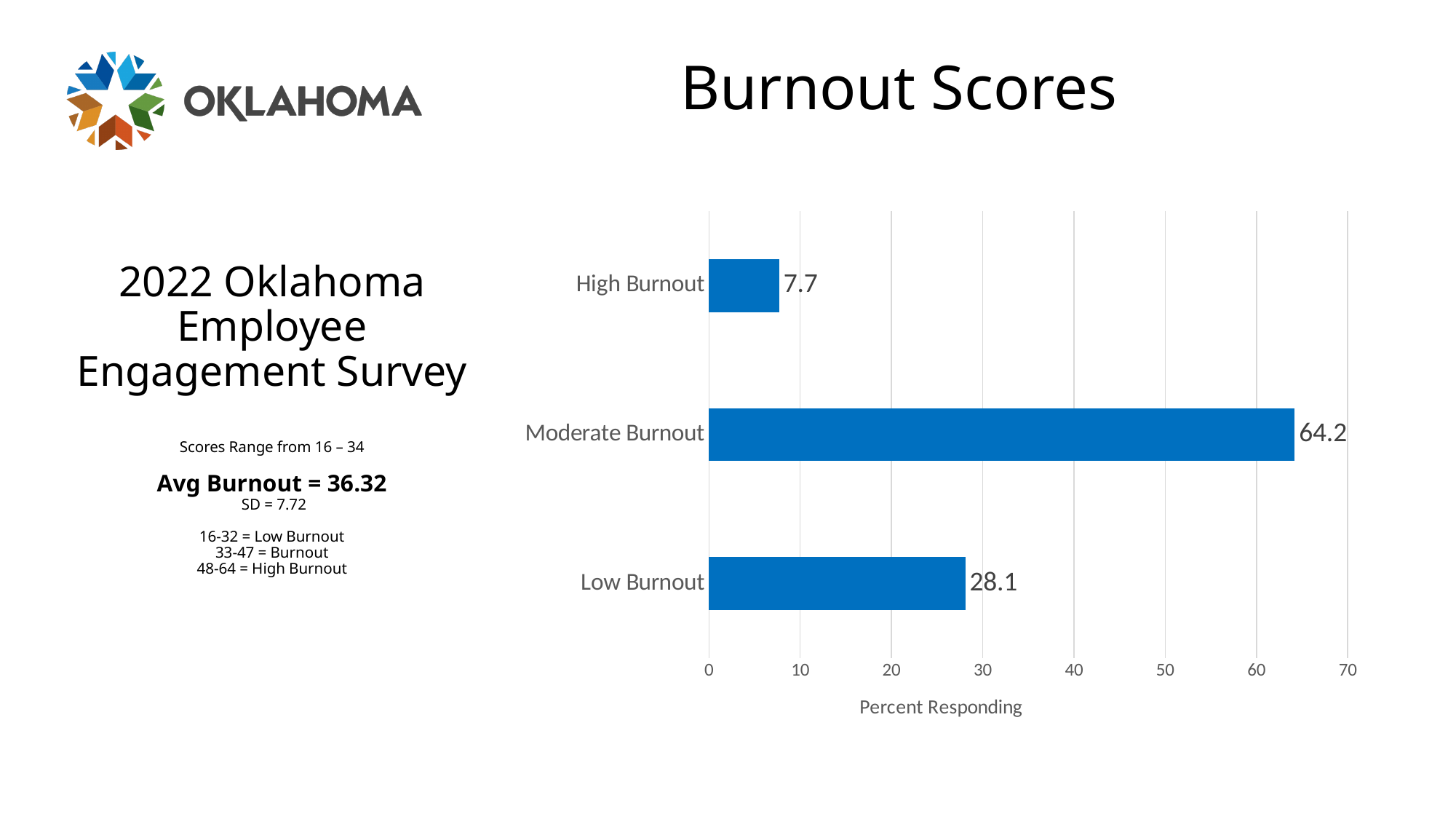
Which category has the highest value? Moderate Burnout What is the label of the horizontal axis? Percent Responding What is the value for Low Burnout? 28.1 What is the value for High Burnout? 7.7 Which is larger, the value for Low Burnout or the value for High Burnout? Low Burnout What is the difference between the values for Low Burnout and High Burnout? 20.4 Is the value for Moderate Burnout greater or less than 60? greater What is the difference between the values for Moderate Burnout and Low Burnout? 36.1 How many categories are shown in the chart? 3 Which category has the lowest value? High Burnout What kind of chart is shown on the slide? bar chart What is the value for Moderate Burnout? 64.2